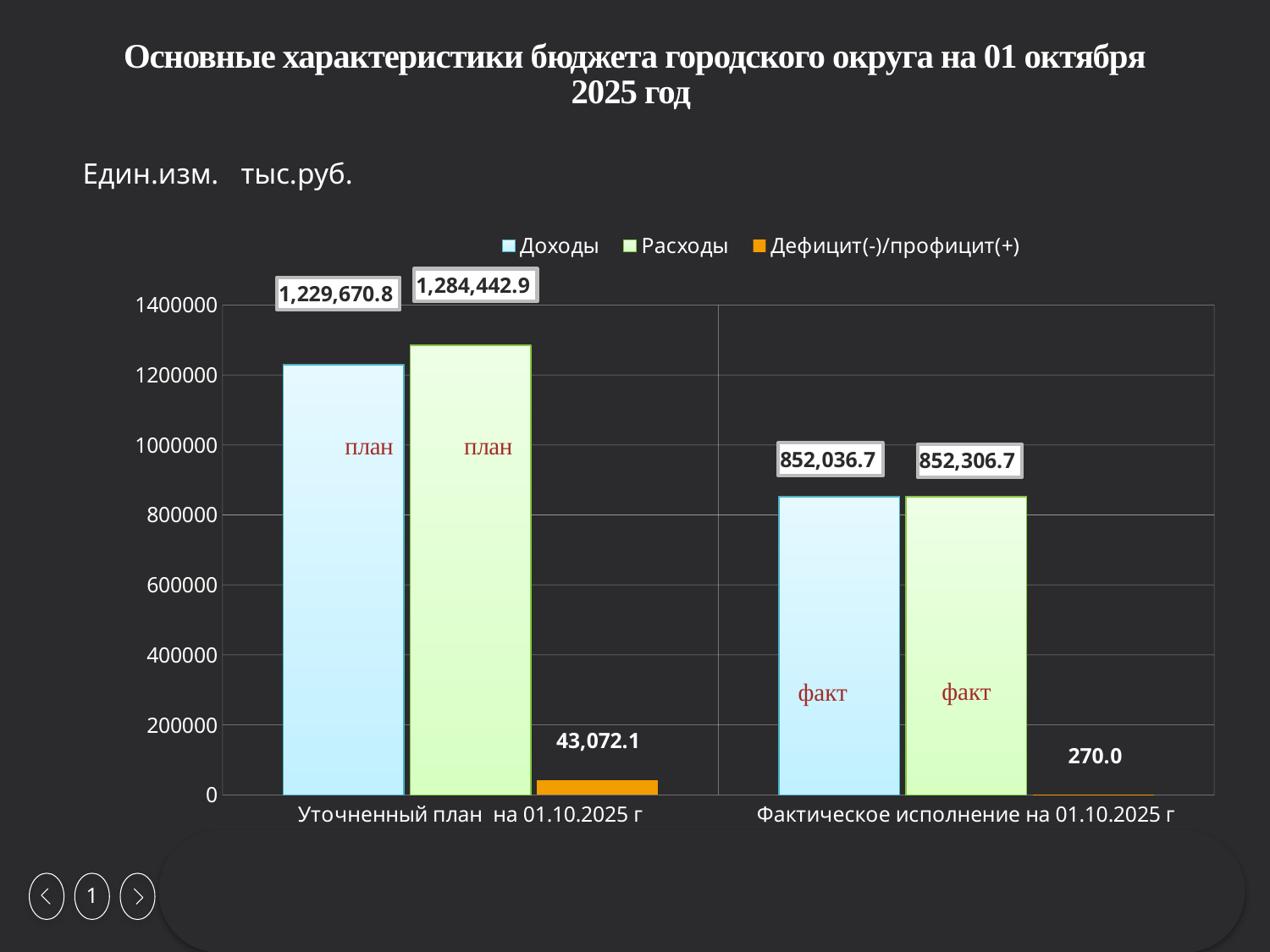
How many categories are shown on the x axis? 2 What is the value of Расходы for Уточненный план на 01.10.2025 г? 1,284,442.9 Is the value of Доходы for Фактическое исполнение на 01.10.2025 г greater or less than 1000000? less What is the value of Дефицит(-)/профицит(+) for Уточненный план на 01.10.2025 г? 43,072.1 For Уточненный план на 01.10.2025 г, which is larger: Доходы or Расходы? Расходы What is the value of Доходы for Уточненный план на 01.10.2025 г? 1,229,670.8 What is the value of Расходы for Фактическое исполнение на 01.10.2025 г? 852,306.7 What is the difference between Расходы and Доходы for Уточненный план на 01.10.2025 г? 54,772.1 What type of chart is shown on the slide? bar chart What is the value of Доходы for Фактическое исполнение на 01.10.2025 г? 852,036.7 What is the value of Дефицит(-)/профицит(+) for Фактическое исполнение на 01.10.2025 г? 270.0 How many series does the legend list? 3